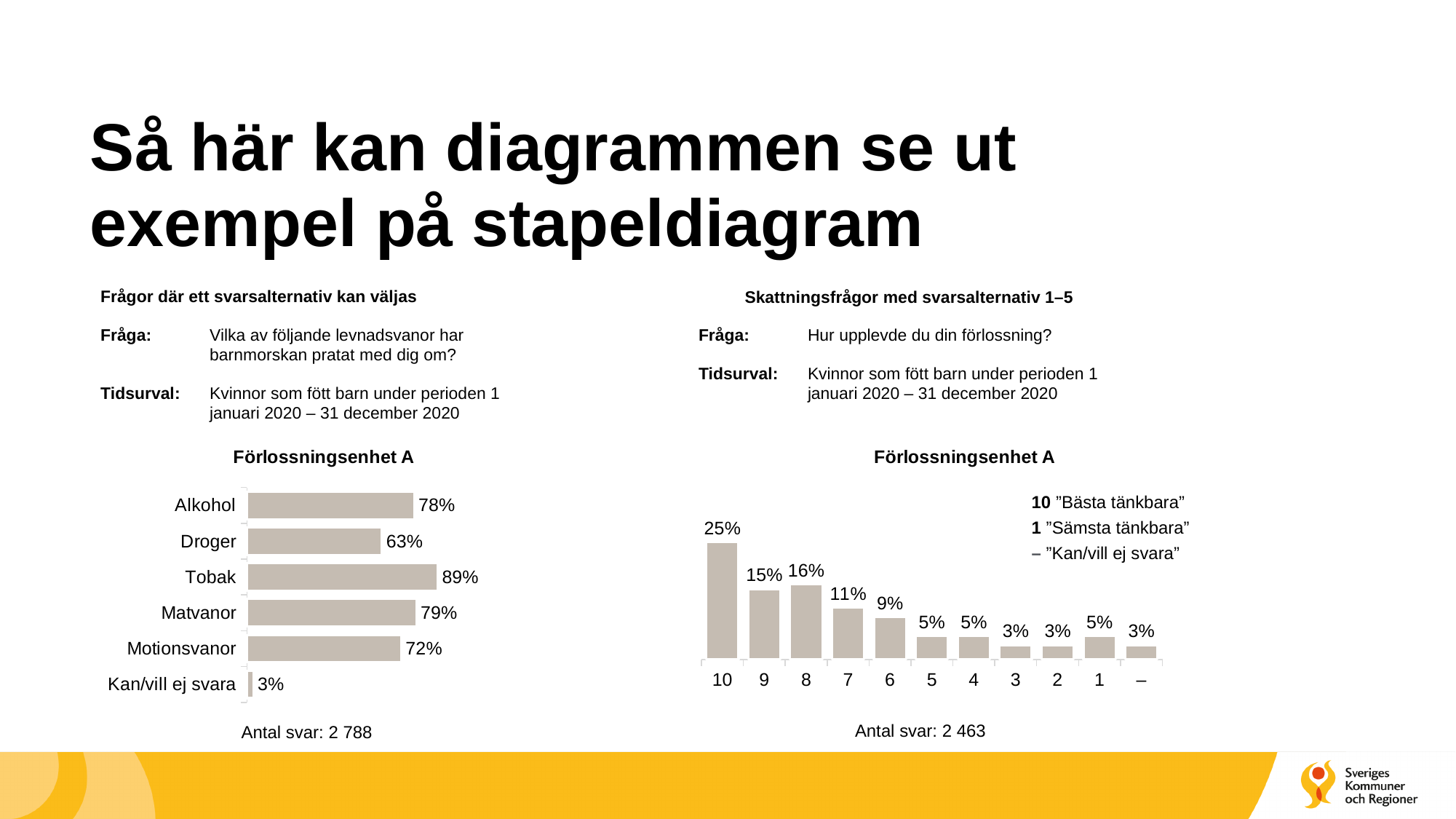
What kind of chart is the left chart? bar chart In the right chart, what is the value for rating 10? 25% In the left chart, what is the value for Droger? 63% In the left chart, what is the difference between the values for Tobak and Motionsvanor? 17% In the left chart, which category has the highest value? Tobak In the right chart, what is the value for rating 7? 11% In the left chart, which category has the lowest value? Kan/vill ej svara In the left chart, what is the value for Tobak? 89% In the right chart, how many bars are shown? 11 In the right chart, which is larger, the value for rating 9 or rating 8? rating 8 In the right chart, which rating has the highest value? 10 In the left chart, how many categories are shown? 6